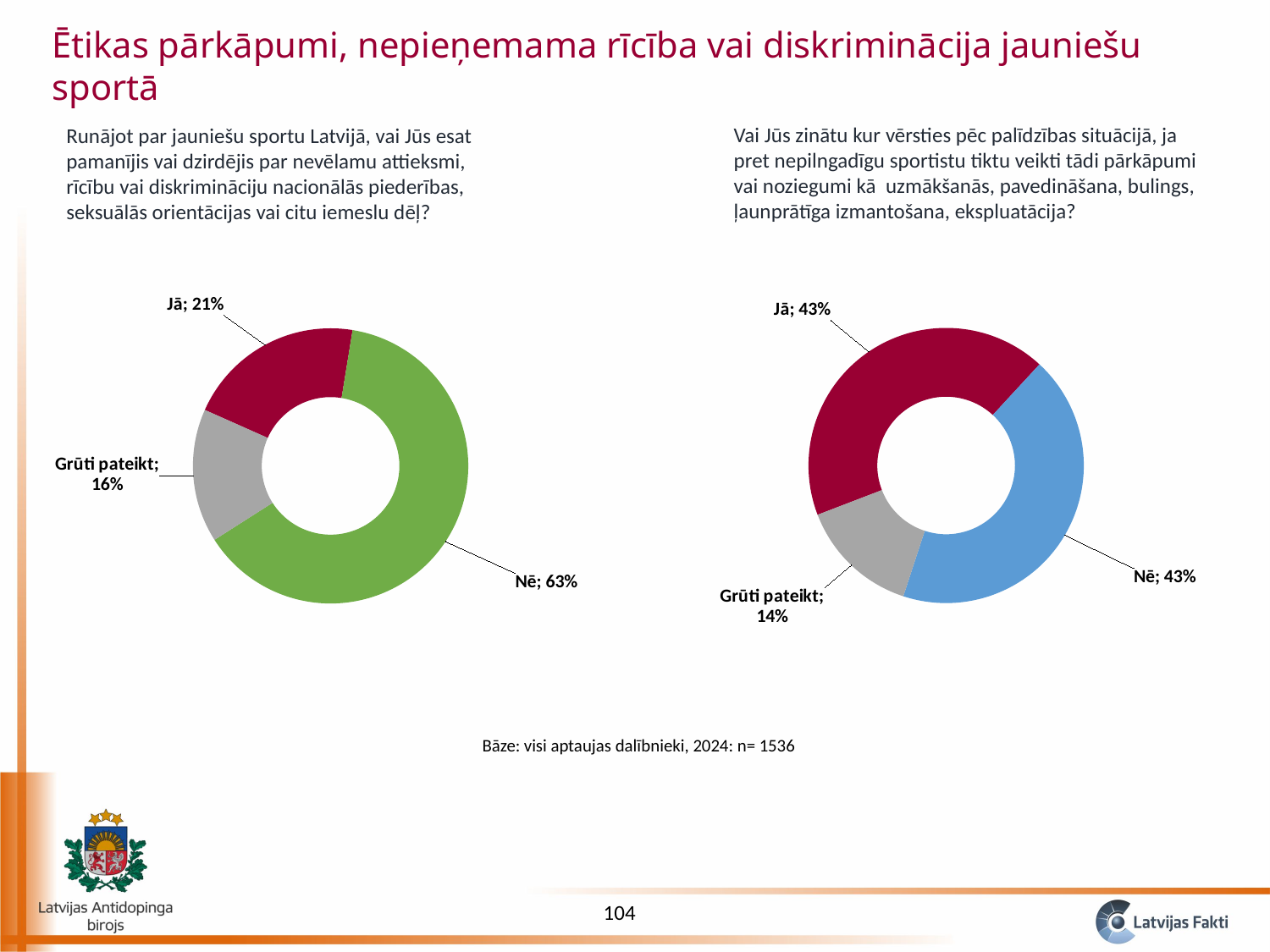
In the left chart, what share of respondents answered "Nē"? 63% In the right chart, what is the difference between the shares for "Jā" and "Grūti pateikt"? 29 percentage points In the right chart, which answer has the smallest share? Grūti pateikt In the left chart, which answer has the smallest share? Grūti pateikt What type of chart is the left chart? Pie chart (doughnut) In the right chart, what share of respondents answered "Jā"? 43% In the left chart, what share of respondents answered "Jā"? 21% In the left chart, which answer has the largest share? Nē In the right chart, what share of respondents answered "Grūti pateikt"? 14% In the left chart, what is the difference between the shares for "Nē" and "Jā"? 42 percentage points In the left chart, what share of respondents answered "Grūti pateikt"? 16% How many slices does the right chart have? 3